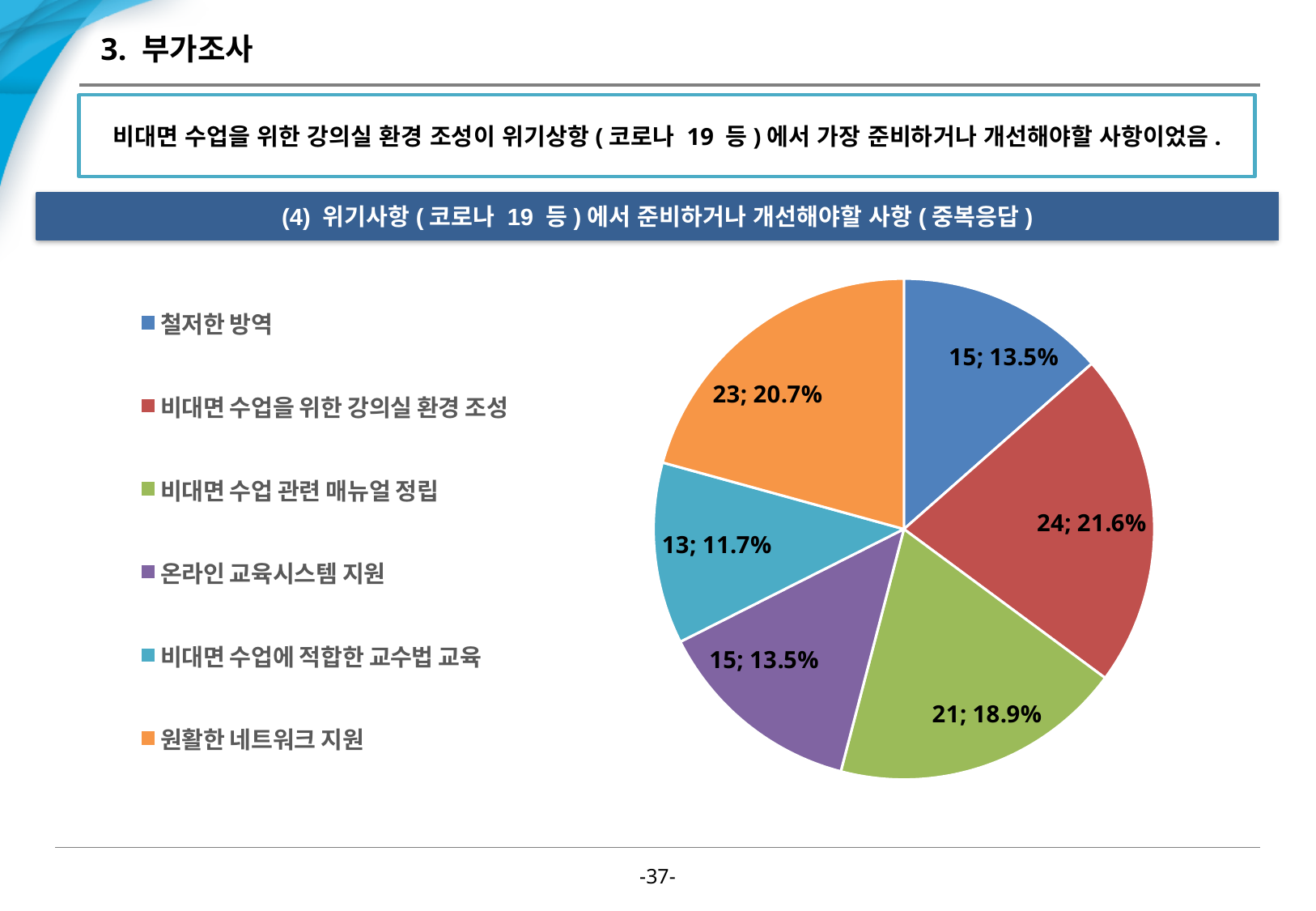
What is the difference in count between 비대면 수업을 위한 강의실 환경 조성 and 비대면 수업에 적합한 교수법 교육? 11 How many slices does the pie chart have? 6 What is the count shown for 비대면 수업을 위한 강의실 환경 조성? 24 What colour is the slice for 온라인 교육시스템 지원? purple What percentage share does 철저한 방역 have in the pie chart? 13.5% Which category has the smallest slice in the pie chart? 비대면 수업에 적합한 교수법 교육 Which has a larger count, 원활한 네트워크 지원 or 비대면 수업 관련 매뉴얼 정립? 원활한 네트워크 지원 Which category has the largest slice in the pie chart? 비대면 수업을 위한 강의실 환경 조성 What type of chart is shown on the slide? pie chart What percentage share does 원활한 네트워크 지원 have in the pie chart? 20.7% What is the count shown for 비대면 수업에 적합한 교수법 교육? 13 What percentage share does 비대면 수업 관련 매뉴얼 정립 have? 18.9%